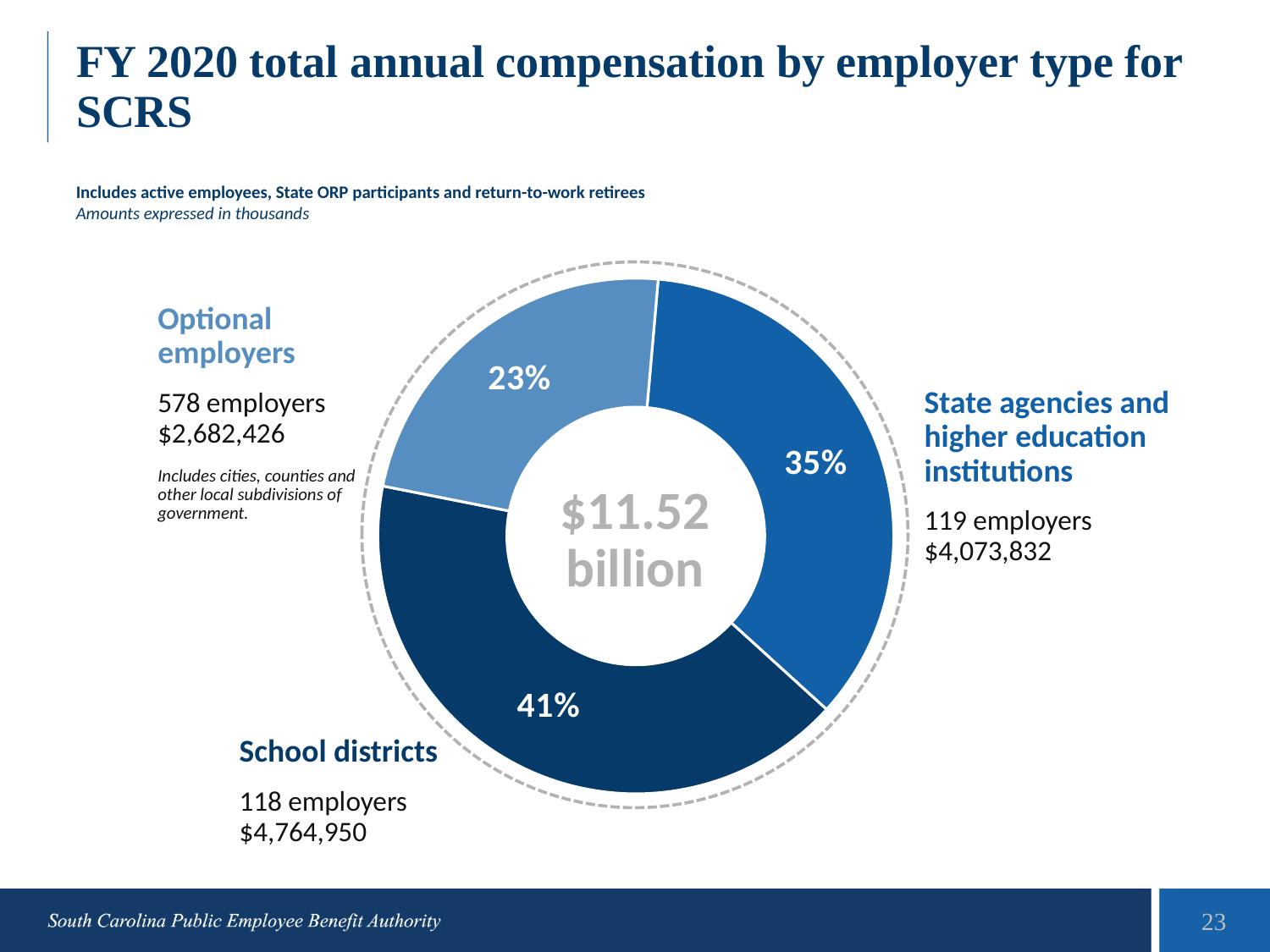
What is the difference in percentage points between the School districts share and the Optional employers share? 18 percentage points How many employers are in the State agencies and higher education institutions category? 119 employers What kind of chart is shown on the slide? Pie (doughnut) chart Which employer type has the largest share of total annual compensation? School districts What is the compensation amount (in thousands) for School districts? $4,764,950 What share of FY 2020 total annual compensation comes from School districts? 41% What share of FY 2020 total annual compensation comes from State agencies and higher education institutions? 35% Which employer type has the smallest share of total annual compensation? Optional employers What is the total annual compensation shown in the centre of the chart? $11.52 billion Which has a larger share of compensation, State agencies and higher education institutions or Optional employers? State agencies and higher education institutions What is the compensation amount (in thousands) for Optional employers? $2,682,426 What share of FY 2020 total annual compensation comes from Optional employers? 23%